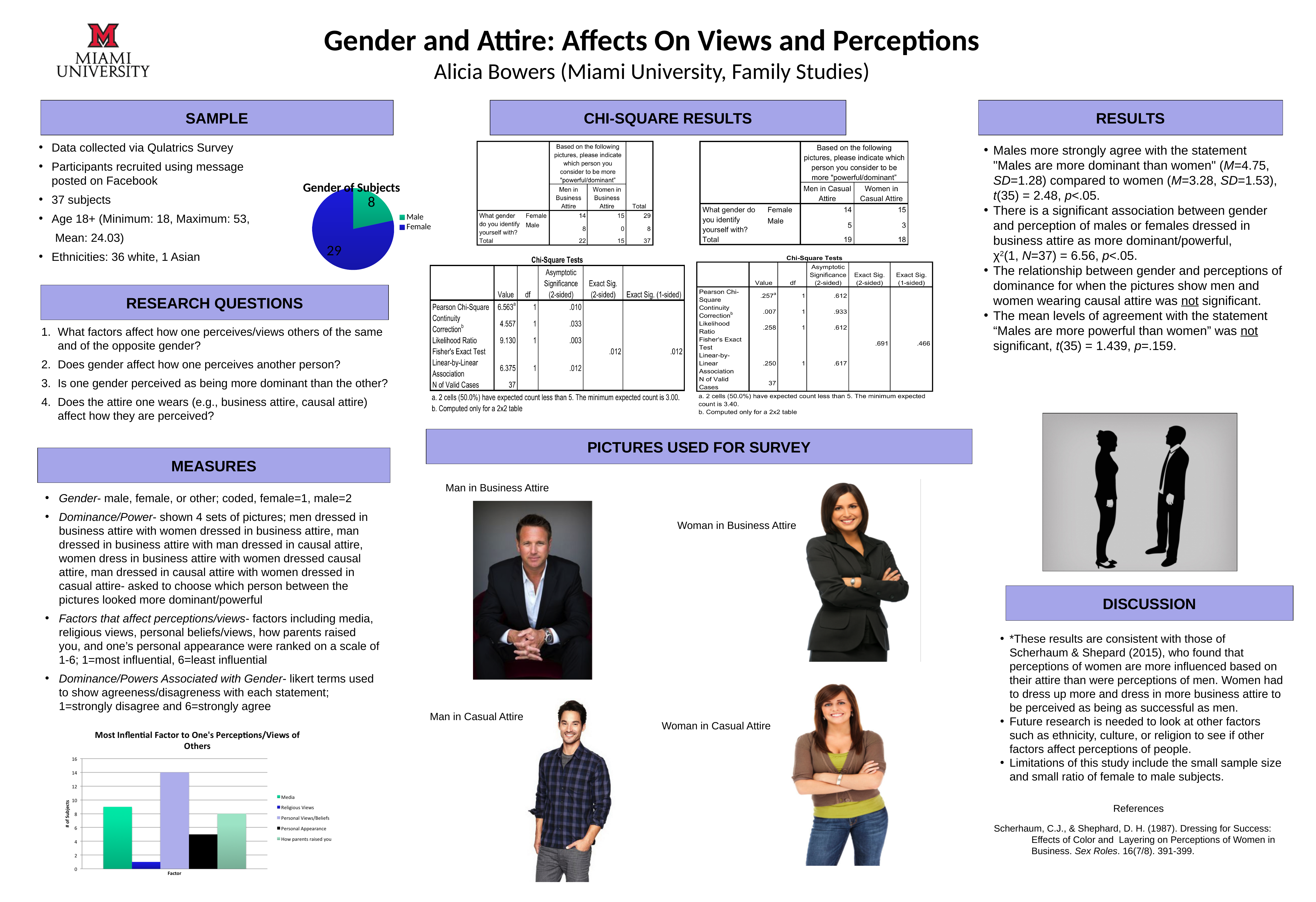
In the Gender of Subjects pie chart, which gender has the larger slice? Female In the 'Most Inflential Factor to One's Perceptions/Views of Others' chart, is the value for Personal Appearance greater or less than 8? less In the 'Most Inflential Factor to One's Perceptions/Views of Others' chart, which factor has the highest bar? Personal Views/Beliefs In the 'Most Inflential Factor to One's Perceptions/Views of Others' chart, how many series does the legend list? 5 In the 'Most Inflential Factor to One's Perceptions/Views of Others' chart, is the value for Media greater or less than 6? greater In the Gender of Subjects pie chart, how many categories does the legend list? 2 In the Gender of Subjects pie chart, how many subjects are female? 29 What type of chart is the 'Most Inflential Factor to One's Perceptions/Views of Others' chart? Bar chart In the Gender of Subjects pie chart, how many subjects are male? 8 In the Gender of Subjects pie chart, how many more female subjects are there than male subjects? 21 What type of chart is the Gender of Subjects chart? Pie chart In the 'Most Inflential Factor to One's Perceptions/Views of Others' chart, which factor has the lowest bar? Religious Views